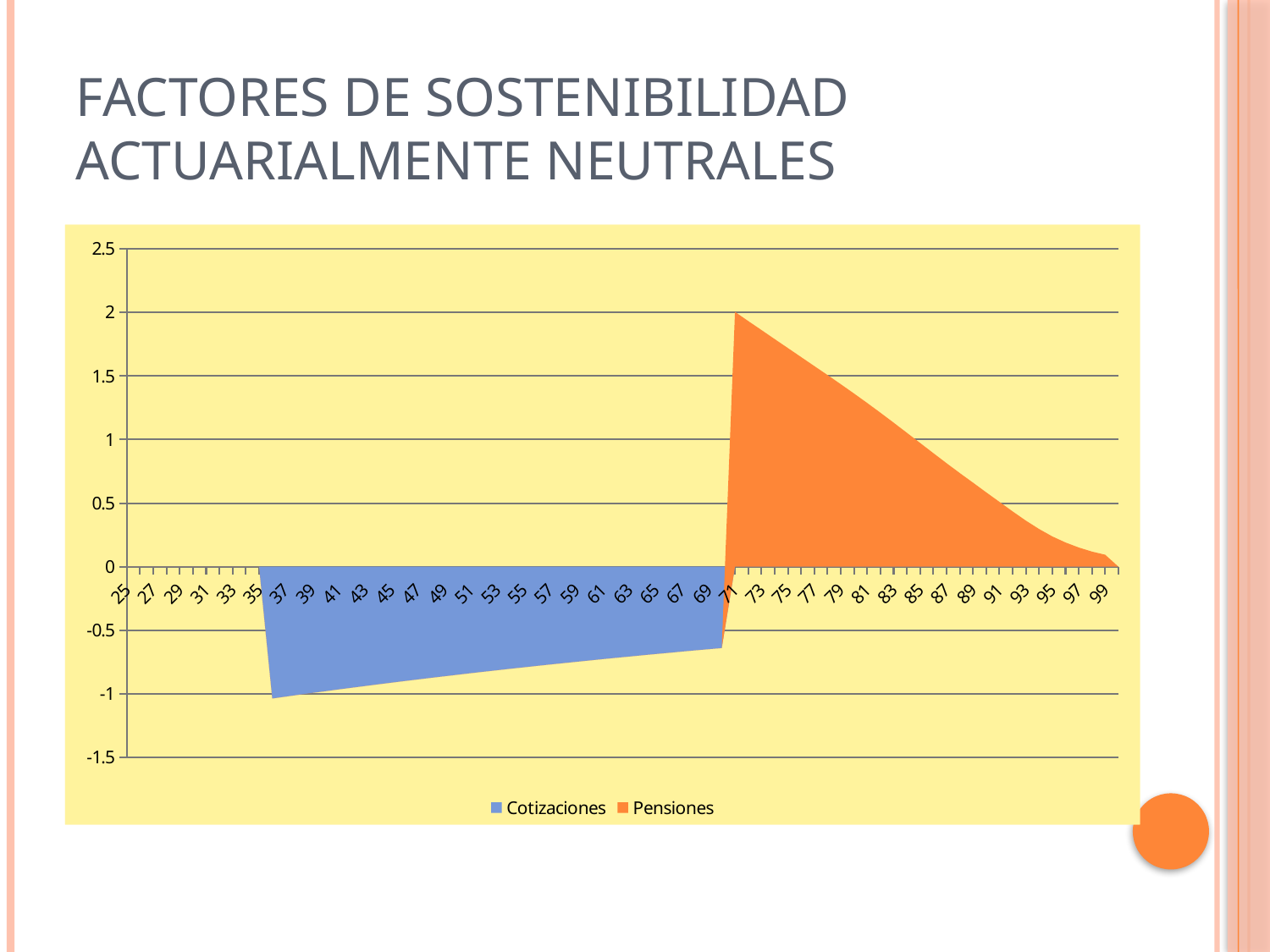
Does the Pensiones series rise or fall from 71 to 99 along the x axis? Fall What kind of chart is shown on the slide? Area chart Is the value for Cotizaciones at 41 greater or less than -0.5? less How many series does the legend list? 2 Which series has negative values? Cotizaciones What are the two series named in the legend? Cotizaciones and Pensiones Is the value for Pensiones at 95 greater or less than 0.5? less Which is larger, the Pensiones value at 73 or at 93? 73 At which x-axis value does the Pensiones series reach its highest point? 71 Which colour represents the Pensiones series? Orange Is the value for Pensiones at 73 greater or less than 1.5? greater Which is larger, the Cotizaciones value at 37 or at 69? 69